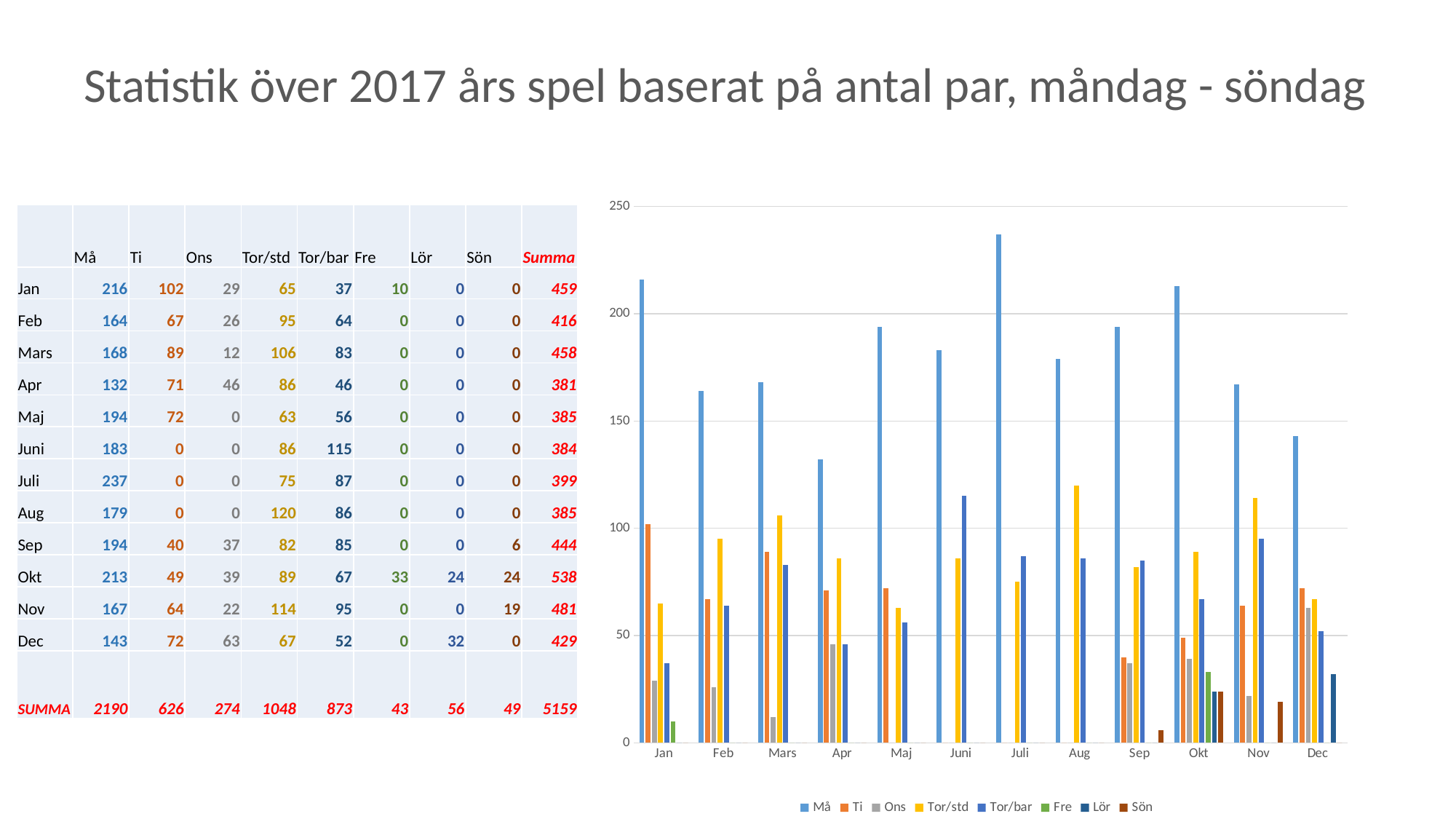
Is the Må value for Juli greater or less than 200? greater What is the Må value for Jan? 216 What is the difference between the Må value for Juli and the Må value for Apr? 105 Which series is shown in yellow in the chart's legend? Tor/std Which month has the lowest Må value in the chart? Apr Is the Tor/std value for Aug greater or less than 100? greater What kind of chart is shown on the slide? bar chart In Feb, which is larger: the Tor/std value or the Ti value? Tor/std Which month has the highest Må value in the chart? Juli How many series does the chart's legend list? 8 How many months are shown along the x axis of the chart? 12 What is the Tor/bar value for Juni? 115